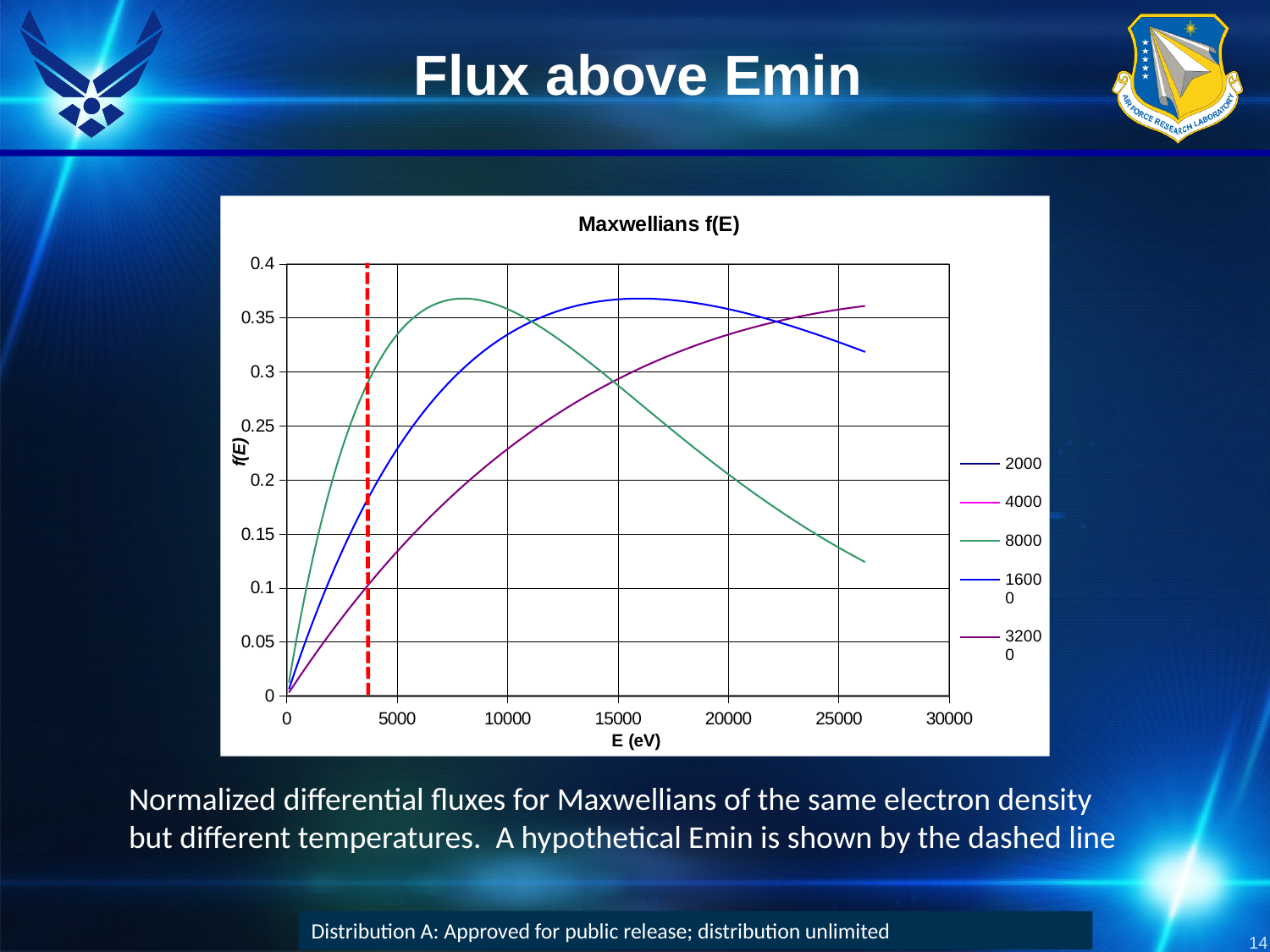
What kind of chart is shown on the slide? line chart Is the value of the 32000 series at E = 10000 greater or less than 0.25? less Is the value of the 16000 series at E = 10000 greater or less than 0.3? greater What is the label of the x axis of the chart? E (eV) At E = 5000, which series has the larger value, 8000 or 16000? 8000 Does the 8000 series rise or fall between E = 10000 and E = 25000? falls What is the title of the chart? Maxwellians f(E) Is the value of the 8000 series at E = 25000 greater or less than 0.15? less How many series does the chart legend list? 5 Does the 32000 series rise or fall as E increases across the plotted range? rises At E = 20000, which series has the larger value, 8000 or 32000? 32000